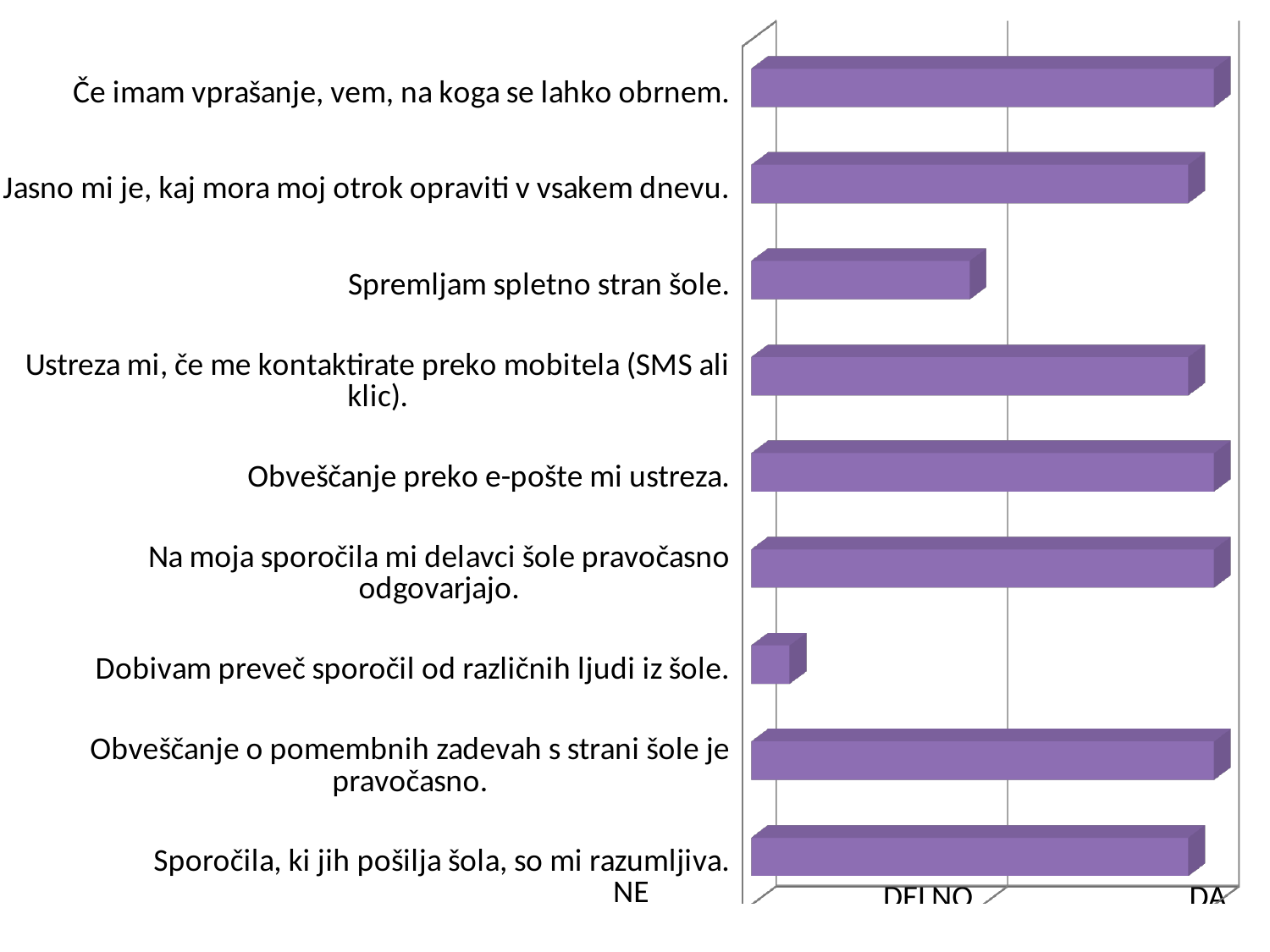
What colour are the bars in the chart? purple Is the value for 'Jasno mi je, kaj mora moj otrok opraviti v vsakem dnevu.' greater or less than DELNO? greater Is the value for 'Sporočila, ki jih pošilja šola, so mi razumljiva.' greater or less than DELNO? greater Is the value for 'Spremljam spletno stran šole.' greater or less than DELNO? less What are the three labels shown on the horizontal axis of the chart? NE, DELNO, DA Which has the larger value: 'Obveščanje preko e-pošte mi ustreza.' or 'Spremljam spletno stran šole.'? Obveščanje preko e-pošte mi ustreza. Which statement has the lowest value in the chart? Dobivam preveč sporočil od različnih ljudi iz šole. What kind of chart is shown on the slide? bar chart How many categories (statements) are plotted in the chart? 9 Which has the larger value: 'Spremljam spletno stran šole.' or 'Dobivam preveč sporočil od različnih ljudi iz šole.'? Spremljam spletno stran šole.